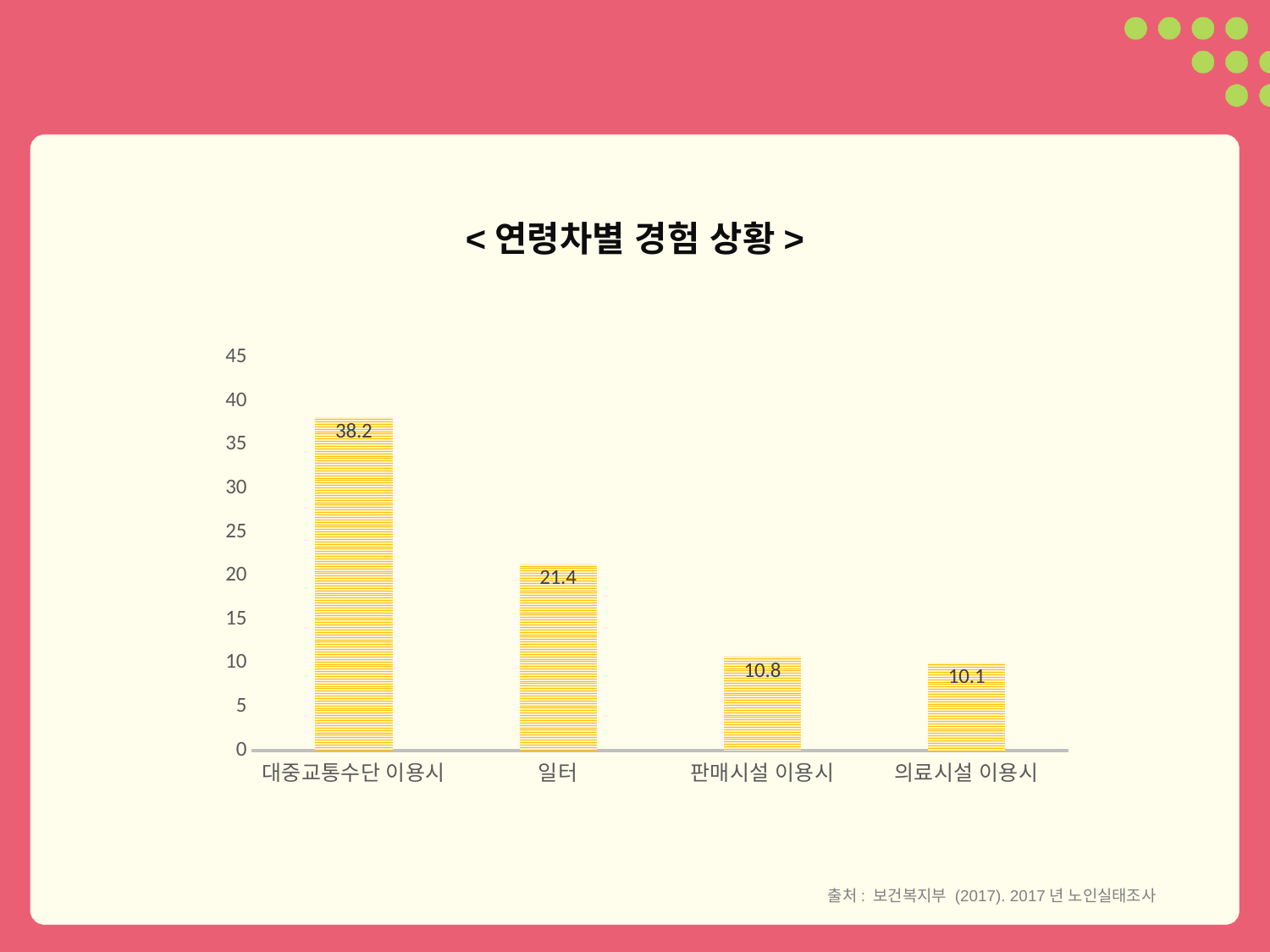
What is the value for 의료시설 이용시? 10.1 What is the title of the chart? < 연령차별 경험 상황 > What kind of chart is shown on the slide? bar chart Which category has the highest value? 대중교통수단 이용시 What is the value for 대중교통수단 이용시? 38.2 What is the difference between the values for 대중교통수단 이용시 and 일터? 16.8 What is the value for 일터? 21.4 What is the value for 판매시설 이용시? 10.8 How many categories are shown in the chart? 4 Which category has the lowest value? 의료시설 이용시 Which is larger, the value for 일터 or the value for 판매시설 이용시? 일터 What is the difference between the values for 판매시설 이용시 and 의료시설 이용시? 0.7